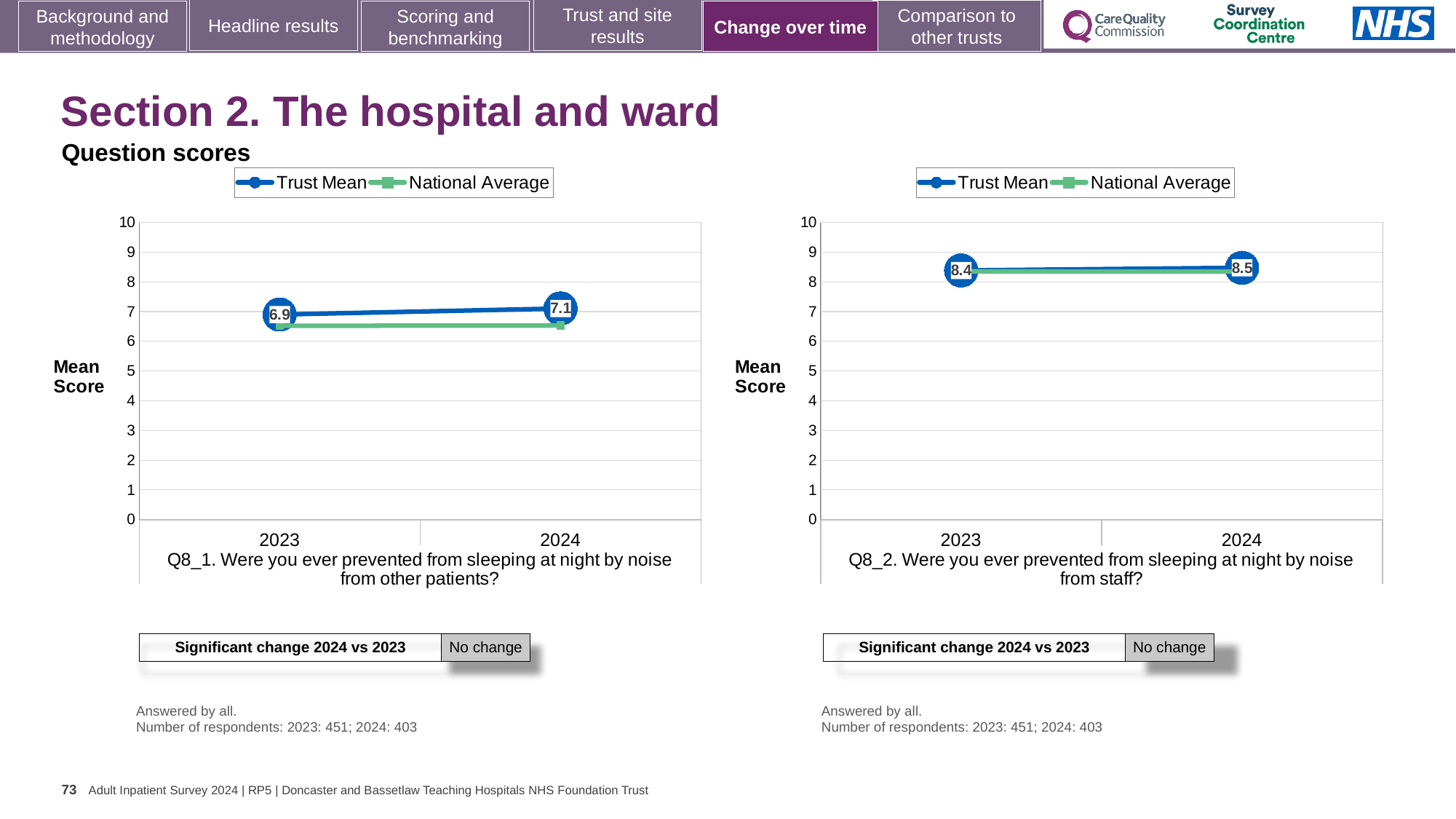
How many series does the legend of the Q8_2 chart (right) list? 2 In the Q8_2 chart (right), what is the Trust Mean for 2023? 8.4 In the Q8_1 chart (left), which is larger in 2024, the Trust Mean or the National Average? Trust Mean In the Q8_1 chart (left), is the National Average for 2023 greater or less than 7? less In the Q8_1 chart (left), by how much did the Trust Mean change from 2023 to 2024? 0.2 How many years are plotted on the x axis of the Q8_1 chart (left)? 2 In the Q8_1 chart (left), what is the Trust Mean for 2024? 7.1 In the Q8_1 chart (left), does the Trust Mean rise or fall from 2023 to 2024? rise What kind of chart is the Q8_2 chart (right)? line chart In the Q8_1 chart (left), what is the Trust Mean for 2023? 6.9 In the Q8_2 chart (right), what is the Trust Mean for 2024? 8.5 In the Q8_2 chart (right), what is the difference between the Trust Mean for 2024 and 2023? 0.1